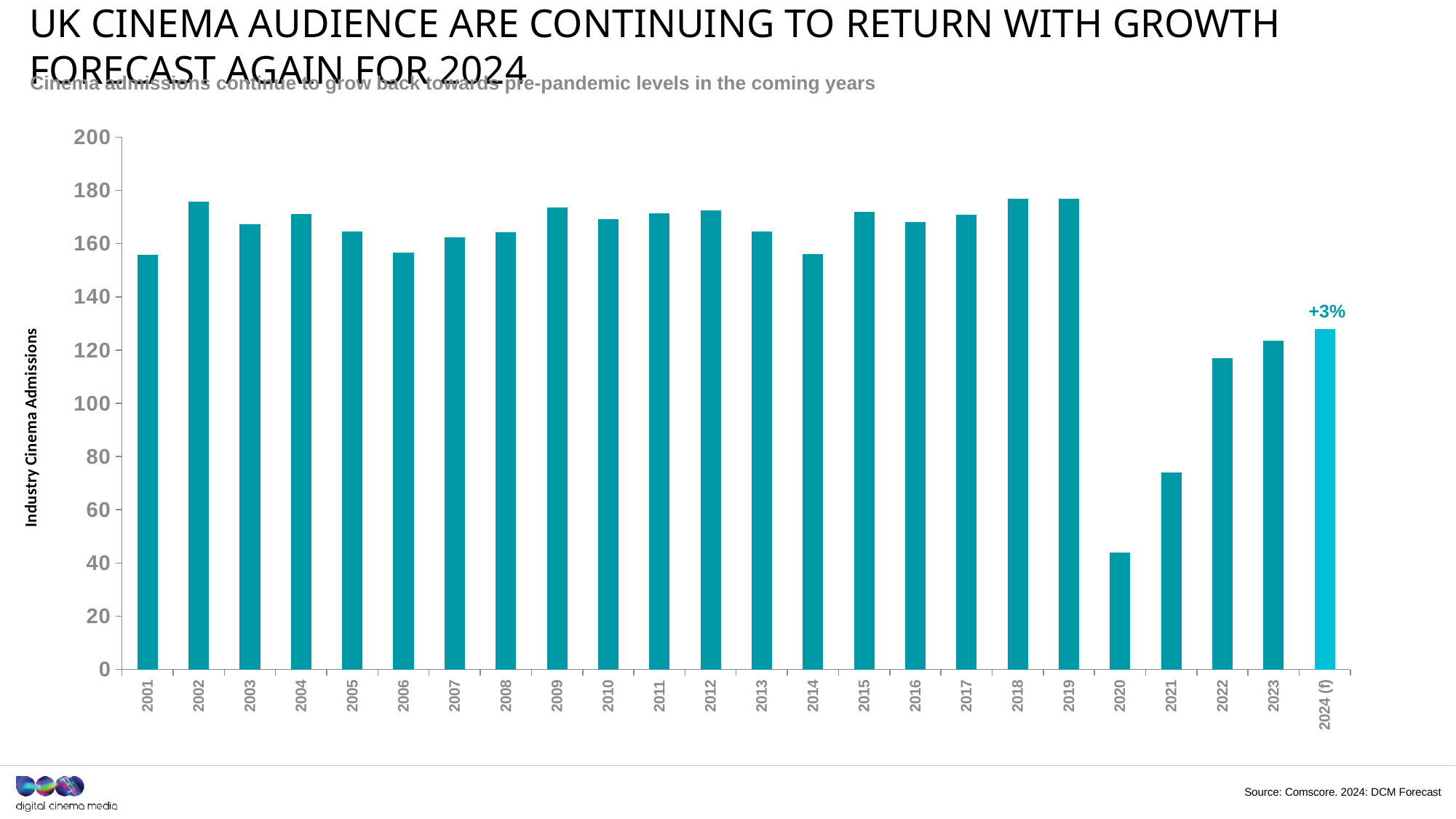
Is the value for 2022 greater or less than 100? greater Is the value for 2021 greater or less than 60? greater Which is larger, the value for 2021 or the value for 2022? 2022 Which year has the lowest industry cinema admissions? 2020 Is the value for 2024 (f) greater or less than 140? less What is the label on the vertical axis of the chart? Industry Cinema Admissions What growth percentage is labelled above the 2024 (f) bar? +3% What kind of chart is shown on the slide? bar chart Which is larger, the value for 2014 or the value for 2015? 2015 How many years (bars) are plotted on the chart? 24